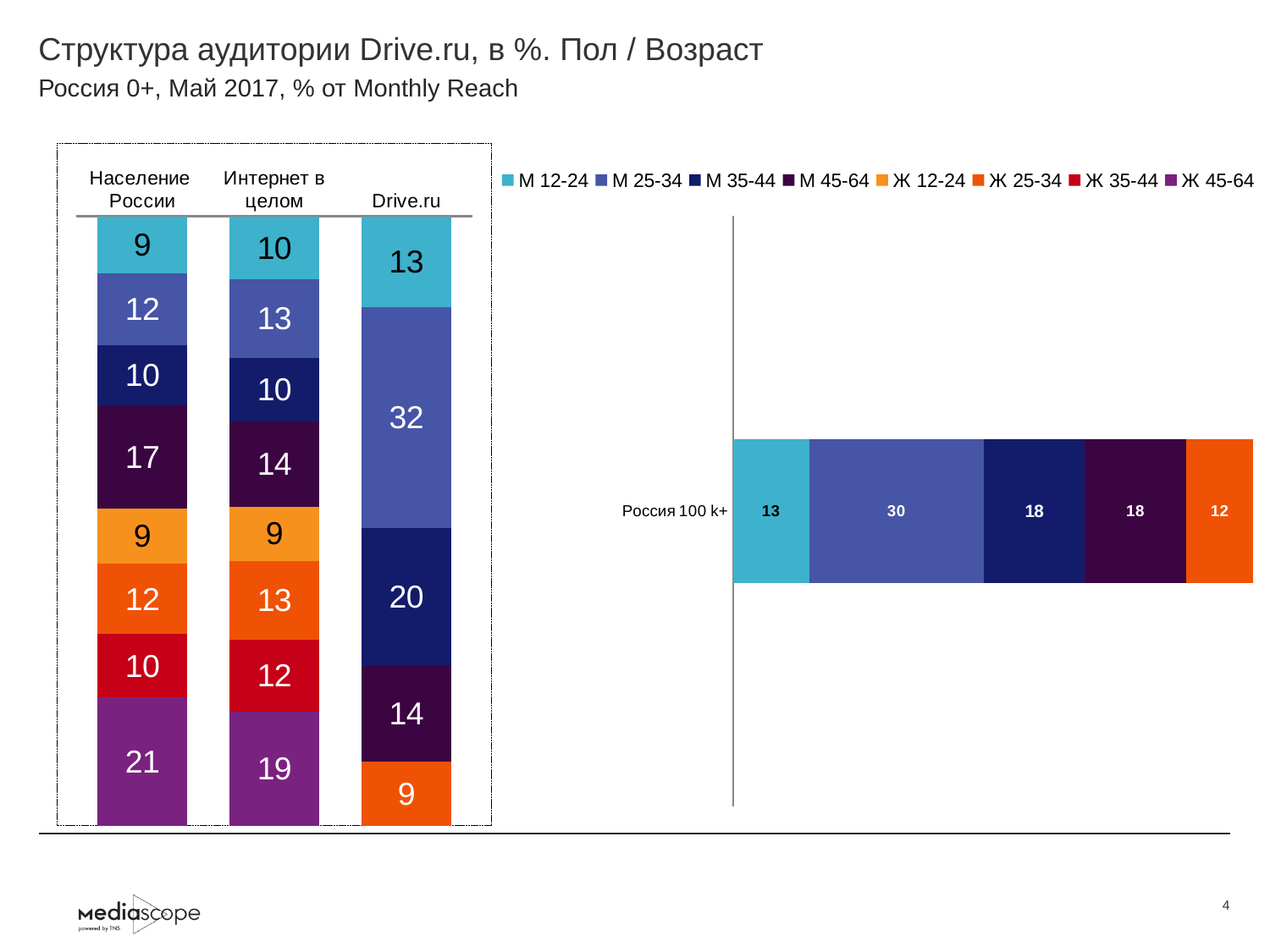
How many series does the legend list? 8 In the left stacked bar chart, which segment of the Drive.ru bar is the largest? М 25-34 In the left stacked bar chart, what is the value of the М 25-34 segment for Drive.ru? 32 In the left stacked bar chart, which is larger: the М 45-64 value for Население России or for Интернет в целом? Население России In the left stacked bar chart, which segment of the Интернет в целом bar is the smallest? Ж 12-24 What is the title of the slide? Структура аудитории Drive.ru, в %. Пол / Возраст In the left stacked bar chart, what is the value of the Ж 45-64 segment for Население России? 21 In the right chart, what is the total of all segments of the Россия 100 k+ bar? 91 How many bars are shown in the left stacked bar chart? 3 In the right chart for Россия 100 k+, what is the value of the М 25-34 segment? 30 In the left stacked bar chart, what is the difference between the М 25-34 values for Drive.ru and Население России? 20 What type of chart is the right chart for Россия 100 k+? Stacked bar chart